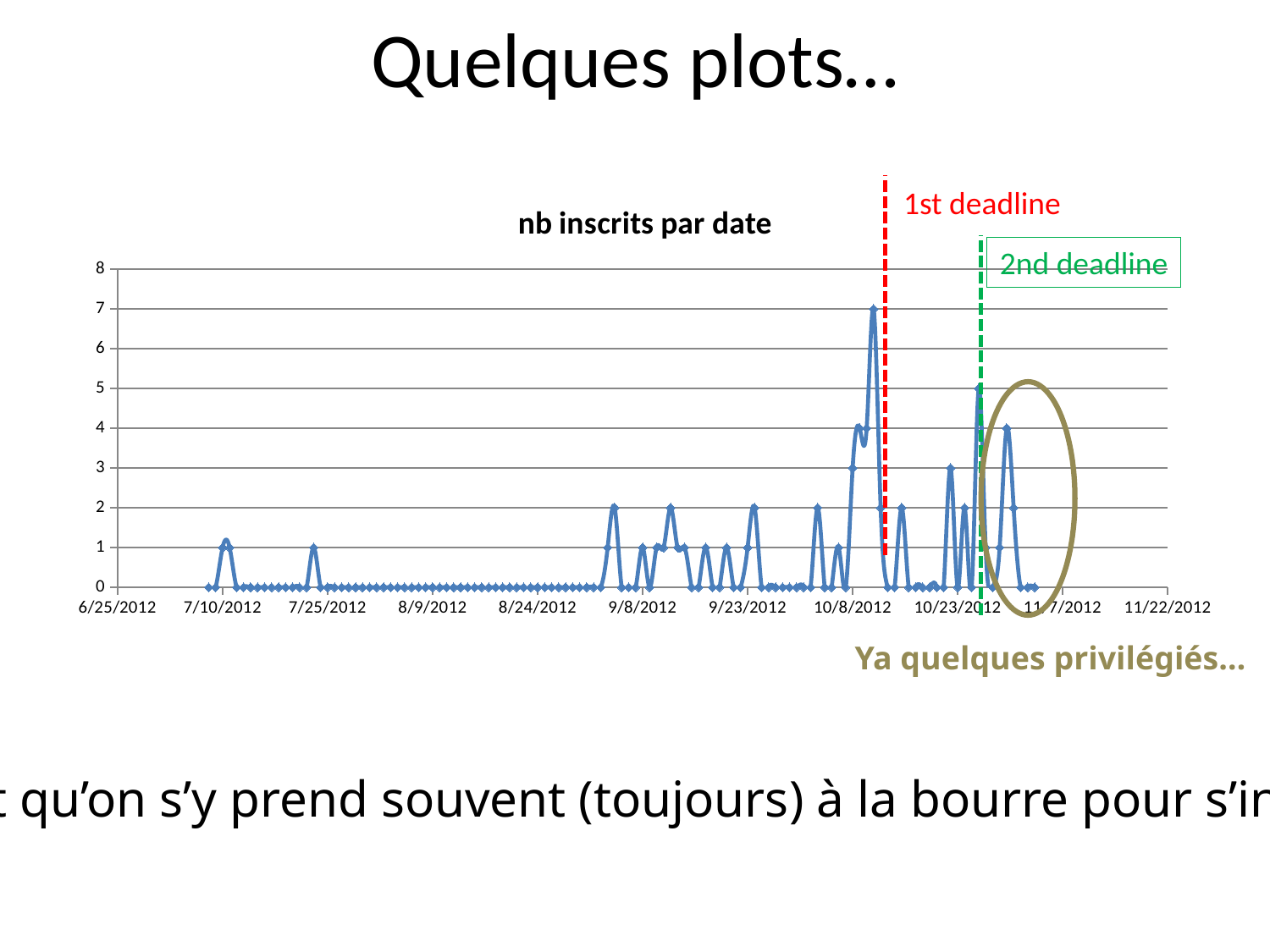
What is the first date label on the horizontal axis? 6/25/2012 What is the title of the chart? nb inscrits par date What is the highest tick shown on the vertical axis? 8 Is the highest peak of the line greater or less than 5? greater Do the plotted values generally rise or fall from July 2012 to early October 2012? rise What kind of chart is shown on the slide? line chart What is the highest value reached by the line in the chart? 7 What is the last date label on the horizontal axis? 11/22/2012 Is the value plotted on 7/25/2012 greater or less than 2? less What is the value plotted on 8/9/2012? 0 Does the highest peak of the line occur before or after the dashed line marked '1st deadline'? before